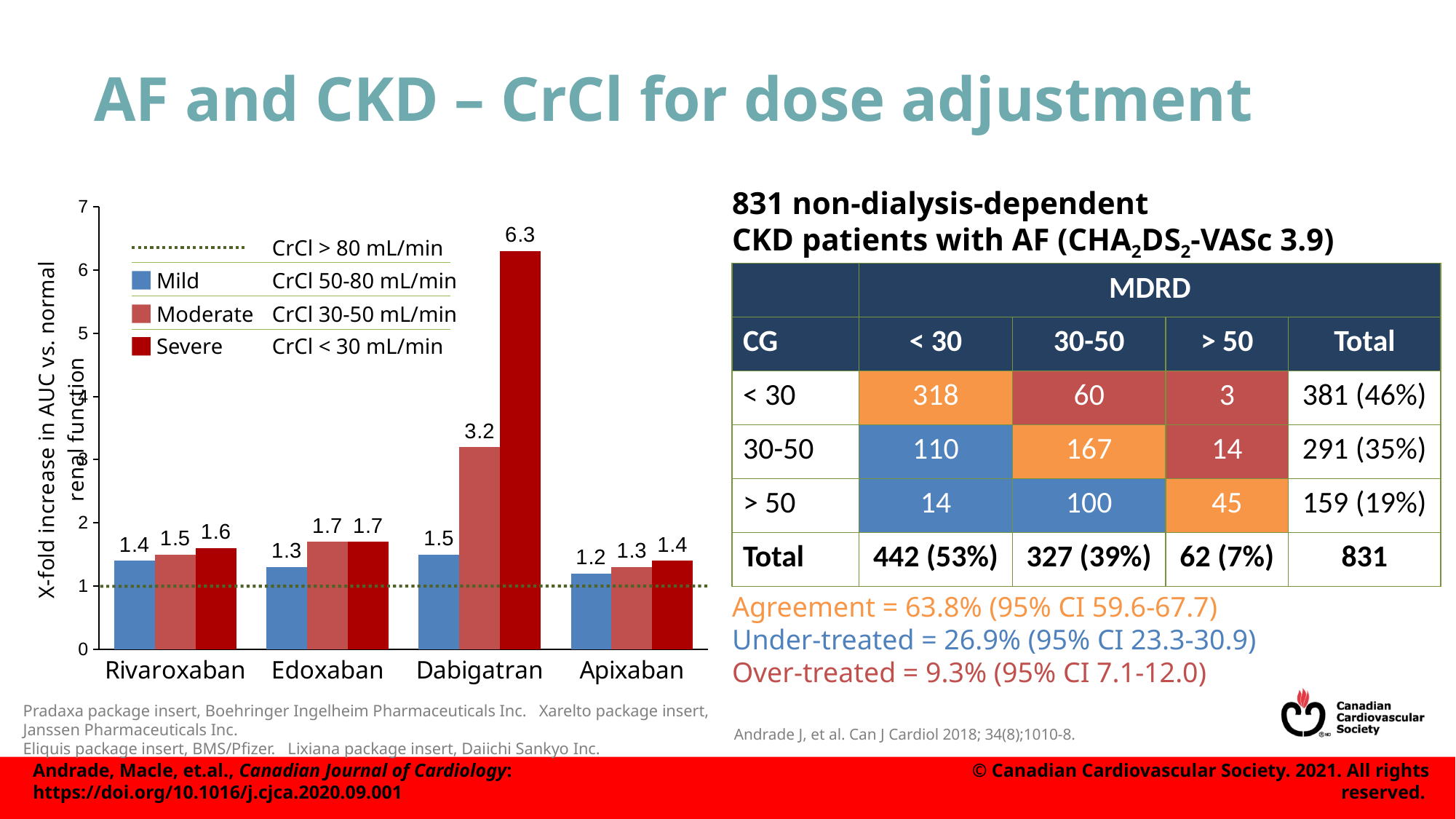
Is the Moderate value for Dabigatran greater or less than 3? greater Which drug has the lowest Mild value? Apixaban How many bar series (renal impairment levels) does the legend list? 3 What is the Mild value for Apixaban? 1.2 What is the Moderate value for Edoxaban? 1.7 What type of chart is shown on the slide? Bar chart What is the Severe value for Dabigatran? 6.3 Which is larger, the Mild value for Dabigatran or the Mild value for Edoxaban? Dabigatran How many drugs are shown on the x axis of the chart? 4 What is the Moderate value for Rivaroxaban? 1.5 Which drug has the highest Severe value? Dabigatran What is the difference between the Severe and Moderate values for Dabigatran? 3.1